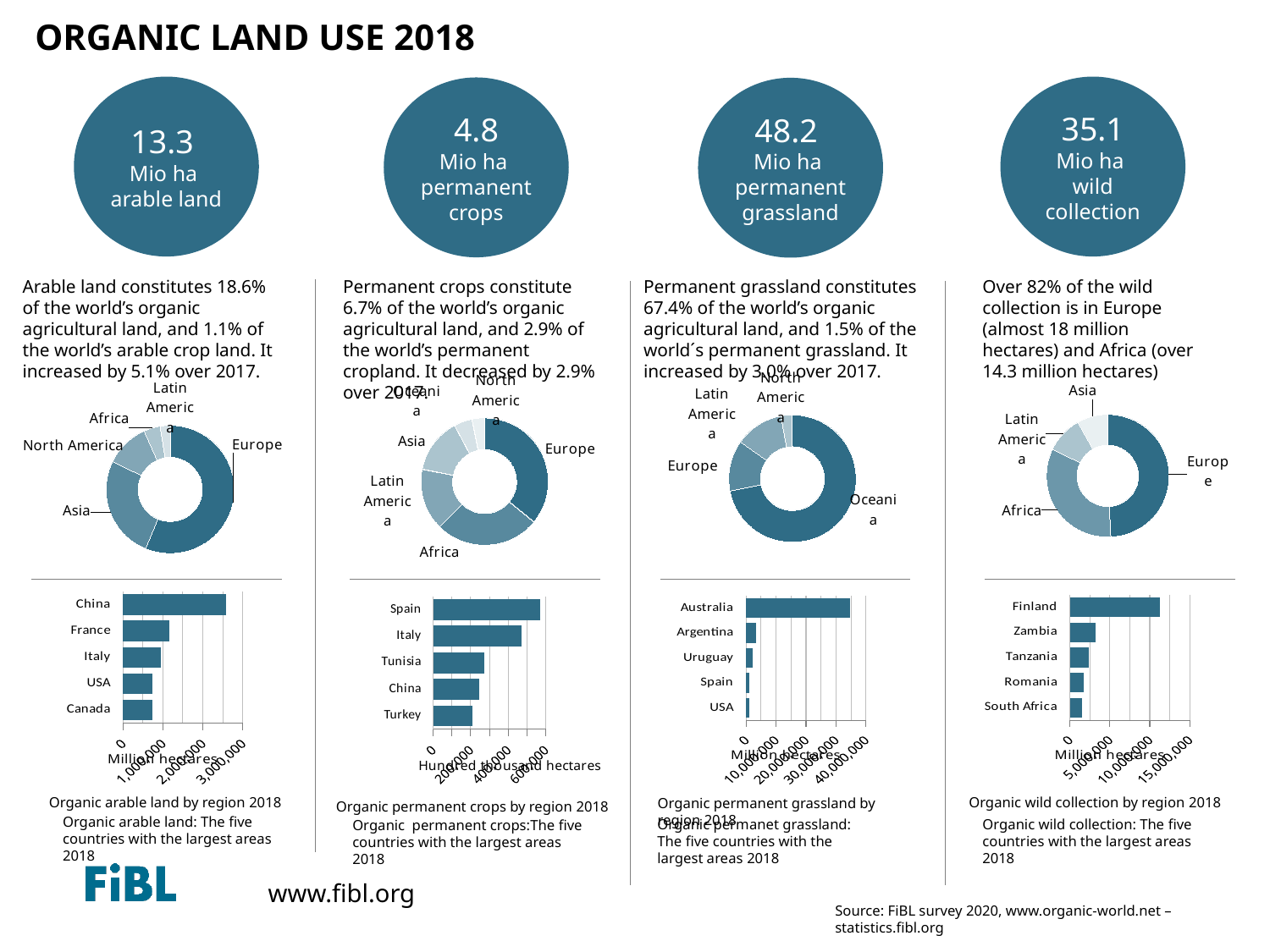
In the 'Organic permanent crops: The five countries with the largest areas 2018' chart, which country has the largest area? Spain In the 'Organic permanent grassland: The five countries with the largest areas 2018' chart, is the value for Argentina greater or less than 10,000,000? less In the 'Organic permanent crops: The five countries with the largest areas 2018' chart, is the value for Spain greater or less than 400,000? greater In the 'Organic wild collection: The five countries with the largest areas 2018' chart, is the value for Finland greater or less than 10,000,000? greater How many countries are shown in the 'Organic permanent crops: The five countries with the largest areas 2018' chart? 5 In the 'Organic arable land: The five countries with the largest areas 2018' chart, which is larger, the value for China or the value for France? China In the 'Organic wild collection: The five countries with the largest areas 2018' chart, which country has the largest area? Finland In the 'Organic permanent grassland by region 2018' chart, which region has the largest share? Oceania What kind of chart is the 'Organic wild collection: The five countries with the largest areas 2018' chart? bar chart